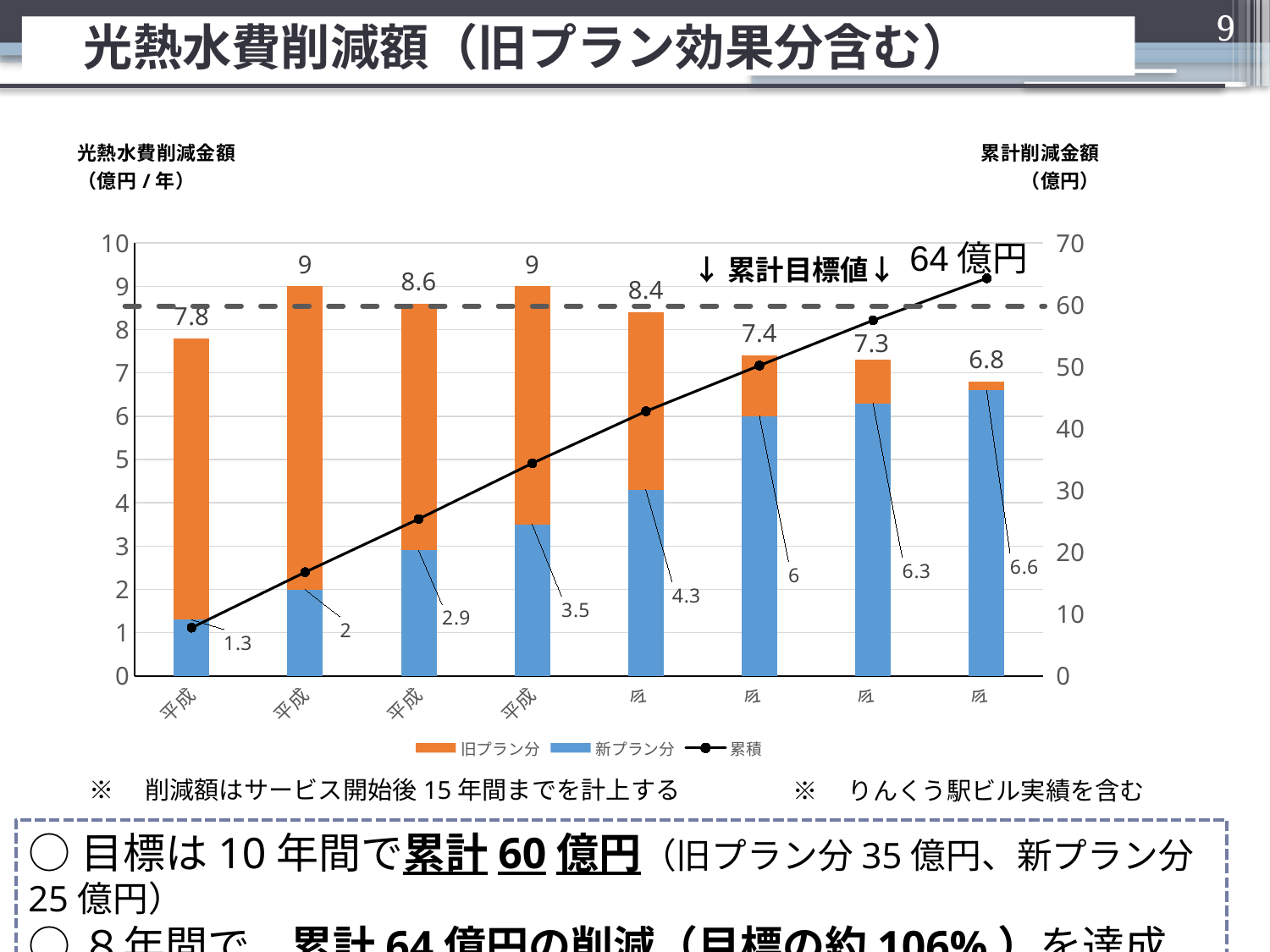
What is the 新プラン分 value for the last (rightmost) bar? 6.6 What kind of chart is shown on the slide? Stacked bar chart with a line Which bar has the lowest total value labelled above it? The last (rightmost) bar, 6.8 What cumulative target value (累計目標値) does the dashed line mark on the right axis? 60 What is the total value labelled above the second bar from the left? 9 What is the final value of the 累積 line, as labelled on the chart? 64 億円 Is the 累積 line value at the fourth bar greater or less than 30 on the right axis? greater What is the difference between the 新プラン分 value of the last bar and that of the first bar? 5.3 How many series does the legend list? 3 How many bars (years) are plotted in the chart? 8 Which bar has the smallest 新プラン分 value? The first (leftmost) bar, 1.3 Do the 新プラン分 values rise or fall from left to right along the x axis? Rise